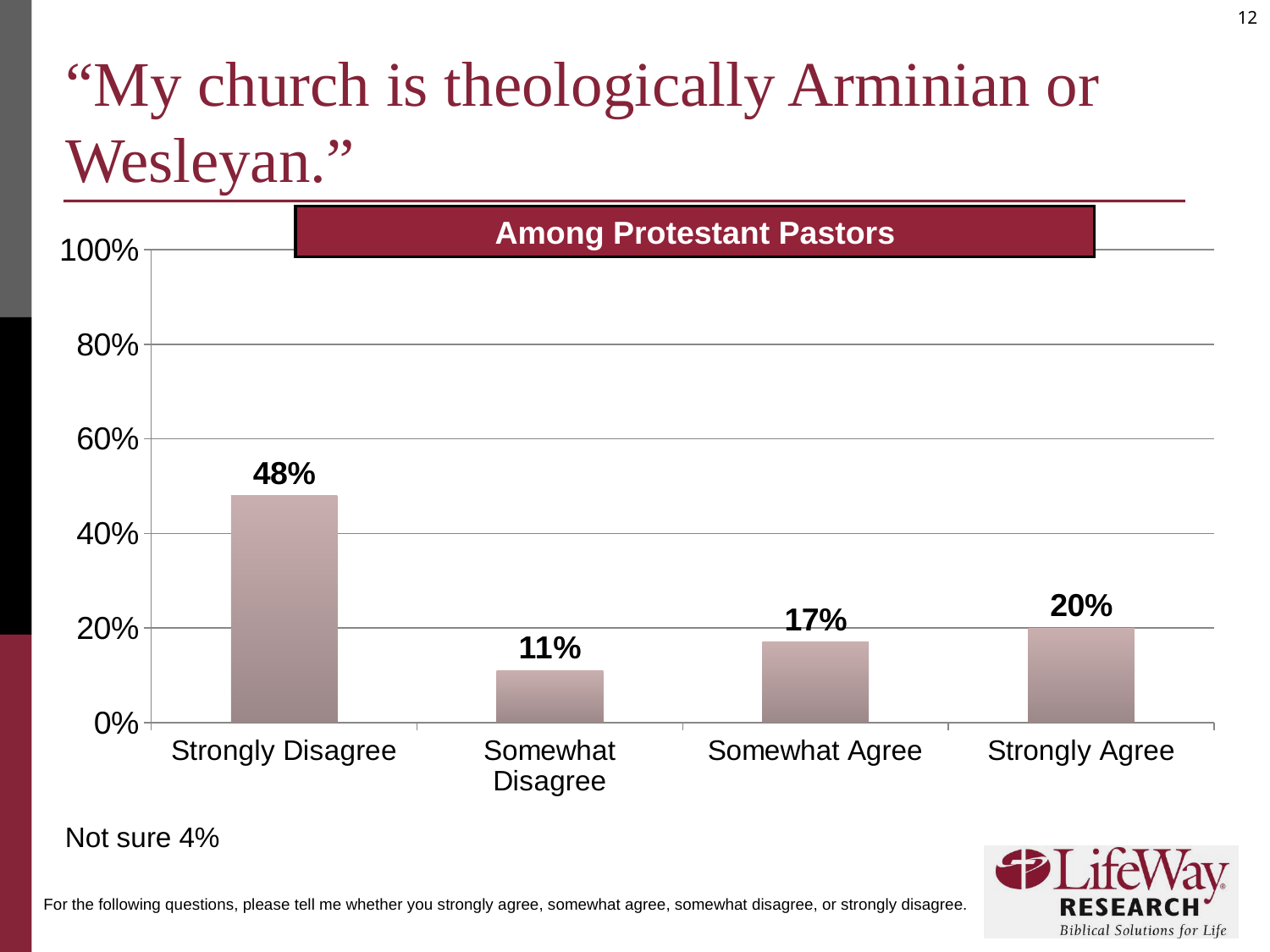
What is the value shown for Somewhat Agree? 17% What percentage of Protestant pastors strongly disagree that their church is theologically Arminian or Wesleyan? 48% Which response category has the highest value? Strongly Disagree What kind of chart is shown on the slide? Bar chart How many response categories are shown on the x axis? 4 What is the difference between the Strongly Disagree and Strongly Agree values? 28% Which response category has the lowest value? Somewhat Disagree What is the value shown for Strongly Agree? 20% What percentage of pastors answered Not sure, according to the note below the chart? 4% Is the value for Strongly Disagree greater or less than 40%? greater What is the value shown for Somewhat Disagree? 11% Which is larger, the value for Somewhat Agree or the value for Strongly Agree? Strongly Agree